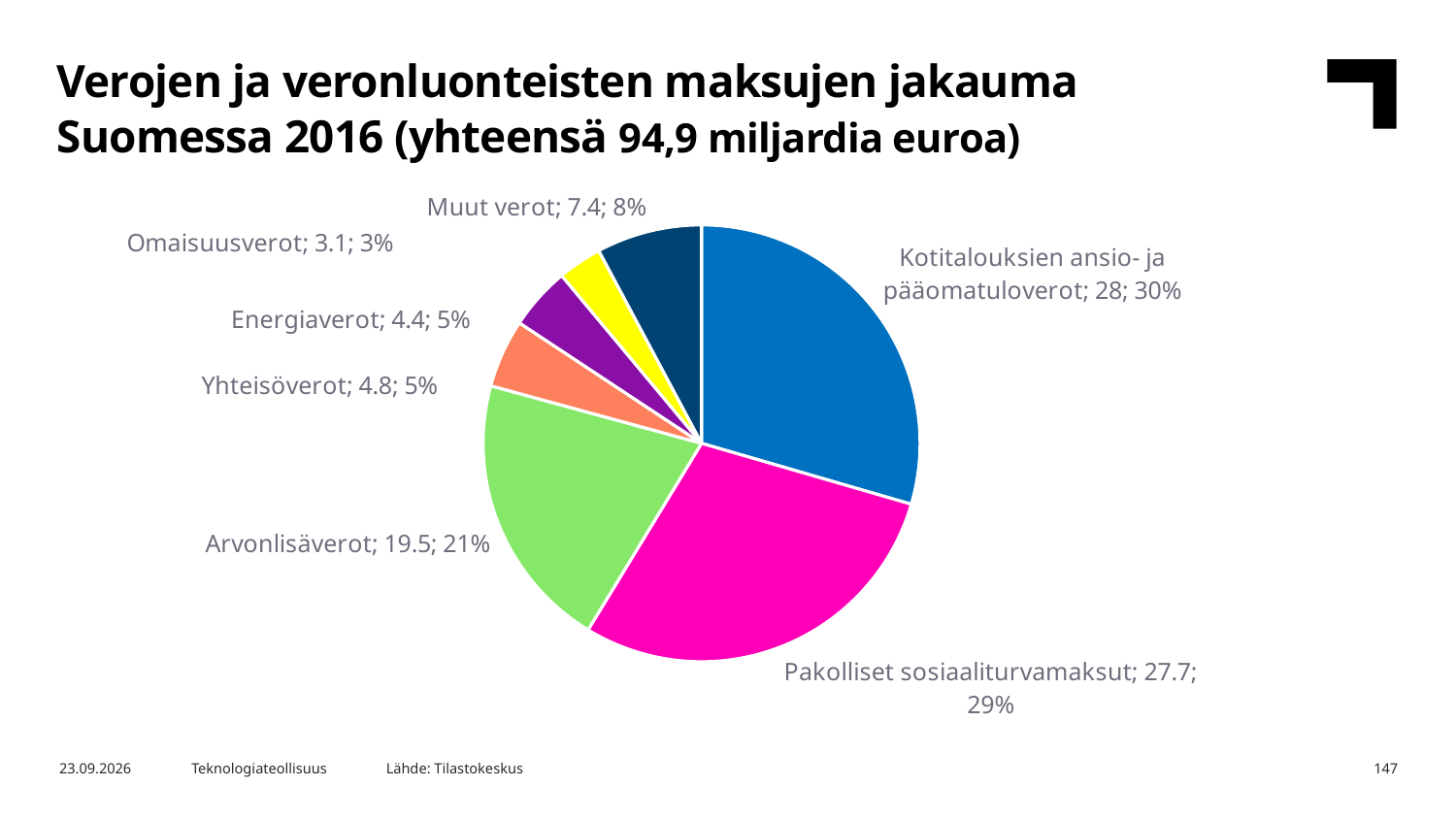
Which category has the largest slice of the pie? Kotitalouksien ansio- ja pääomatuloverot Which is larger, the value for Muut verot or the value for Yhteisöverot? Muut verot Which category has the smallest slice of the pie? Omaisuusverot What percentage share is shown for Pakolliset sosiaaliturvamaksut? 29% What is the value shown for Muut verot? 7.4 What is the value shown for Arvonlisäverot? 19.5 What percentage share is shown for Omaisuusverot? 3% What total amount in billions of euros is stated in the chart title? 94,9 miljardia euroa What kind of chart is shown on the slide? Pie chart How many slices does the pie chart have? 7 What is the difference between the values for Yhteisöverot and Energiaverot? 0.4 What is the difference between the values for Kotitalouksien ansio- ja pääomatuloverot and Pakolliset sosiaaliturvamaksut? 0.3